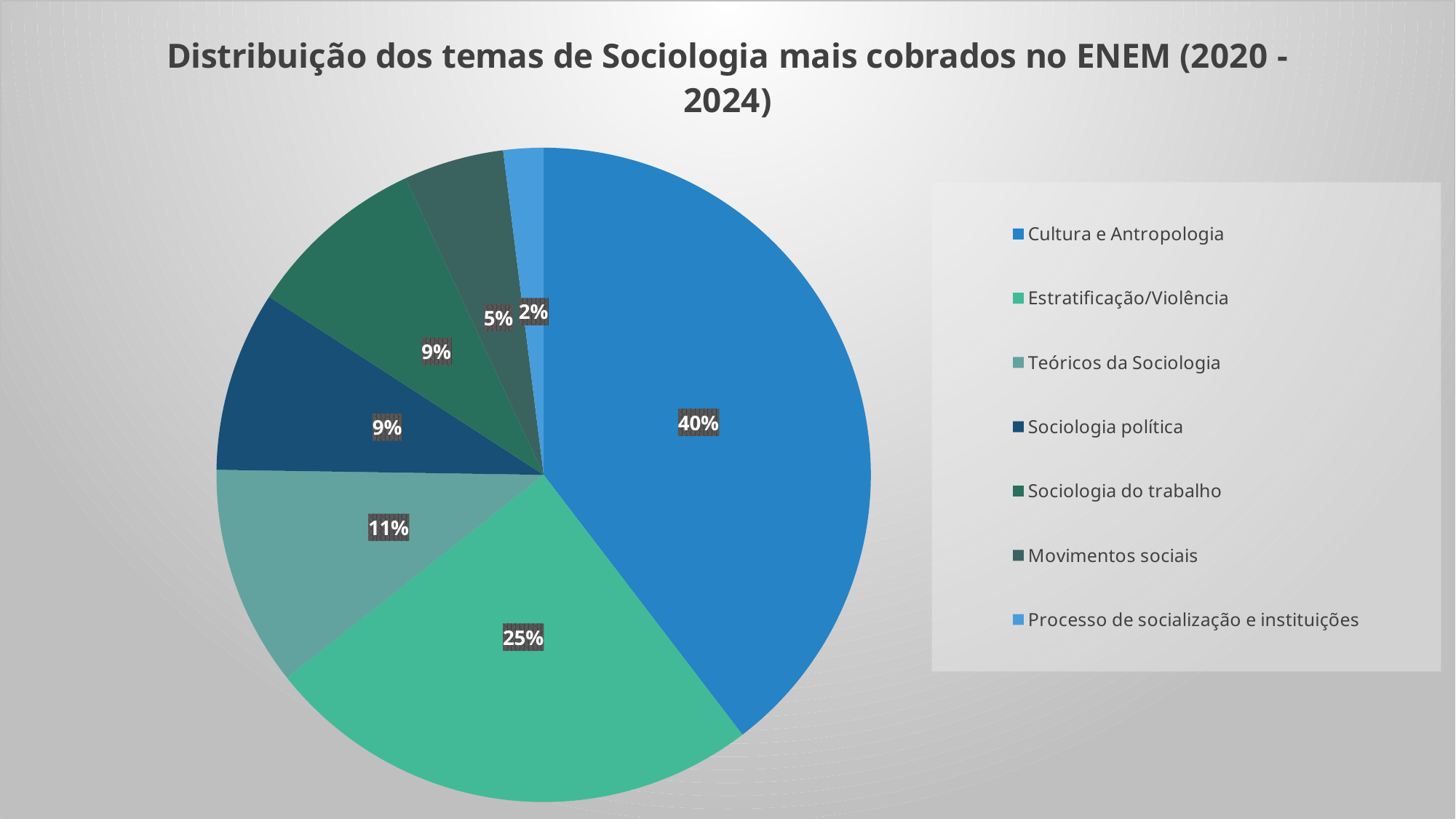
What is the value shown for Estratificação/Violência? 25% What share of the pie does Cultura e Antropologia represent? 40% Which category has the smallest slice of the pie? Processo de socialização e instituições What is the value shown for Processo de socialização e instituições? 2% What is the value shown for Teóricos da Sociologia? 11% Which is larger, the share for Teóricos da Sociologia or the share for Sociologia política? Teóricos da Sociologia How many categories does the pie chart show? 7 What is the title of the chart? Distribuição dos temas de Sociologia mais cobrados no ENEM (2020 - 2024) What is the value shown for Movimentos sociais? 5% What kind of chart is shown on the slide? Pie chart What is the difference between the shares of Cultura e Antropologia and Estratificação/Violência? 15% Which category has the largest slice of the pie? Cultura e Antropologia